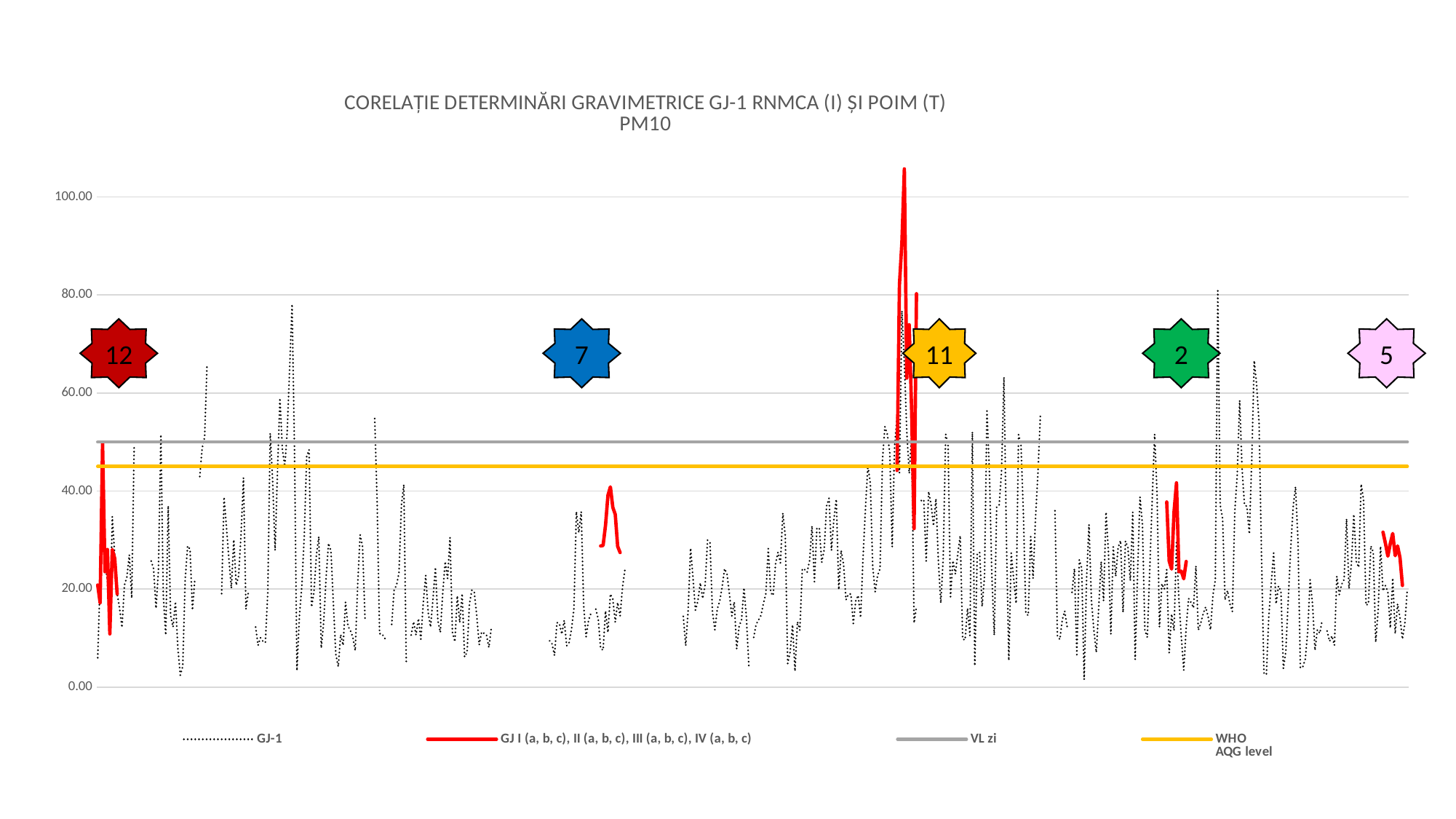
Is the VL zi line greater or less than 60? less Is the VL zi line greater or less than 40? greater Is the WHO AQG level line greater or less than 60? less Which is higher on the chart, the VL zi line or the WHO AQG level line? VL zi What kind of chart is shown on the slide? line chart What is the highest value labelled on the vertical axis? 100.00 What is the title of the chart? CORELAȚIE DETERMINĂRI GRAVIMETRICE GJ-1 RNMCA (I) ȘI POIM (T) PM10 How many series does the legend list? 4 Which legend entry is drawn as a dotted black line? GJ-1